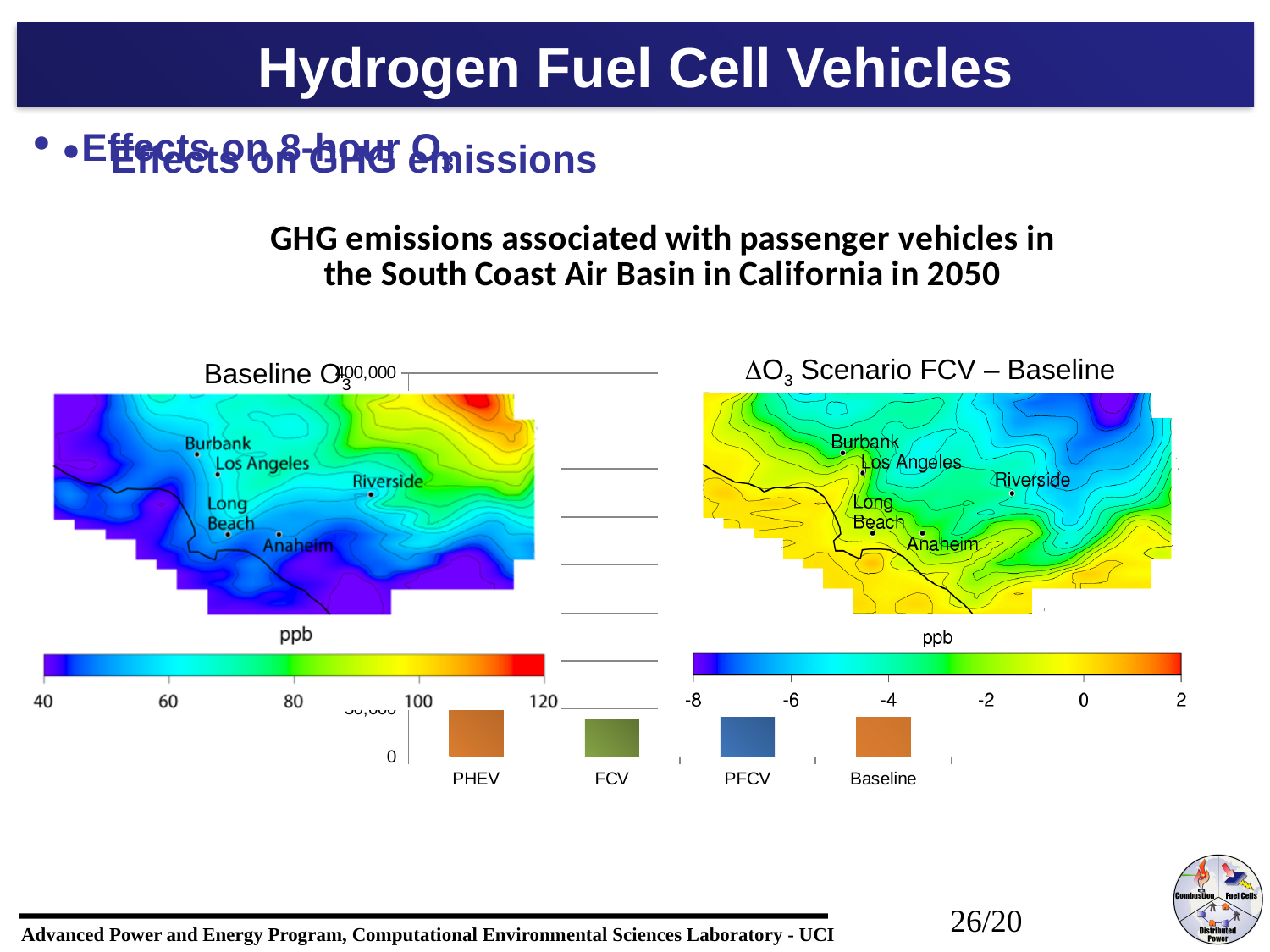
What is the highest value labelled on the y axis of the GHG emissions bar chart? 400,000 What is the title of the bar chart on the slide? GHG emissions associated with passenger vehicles in the South Coast Air Basin in California in 2050 In the GHG emissions bar chart, which category is plotted furthest to the right on the x axis? Baseline In the GHG emissions bar chart, is the bar for PHEV taller or shorter than the bar for FCV? taller What kind of chart is the GHG emissions chart at the bottom of the slide? bar chart In the GHG emissions bar chart, is the value for Baseline greater or less than 400,000? less In the GHG emissions bar chart, is the value for FCV greater or less than 400,000? less How many vehicle categories are shown on the x axis of the GHG emissions bar chart? 4